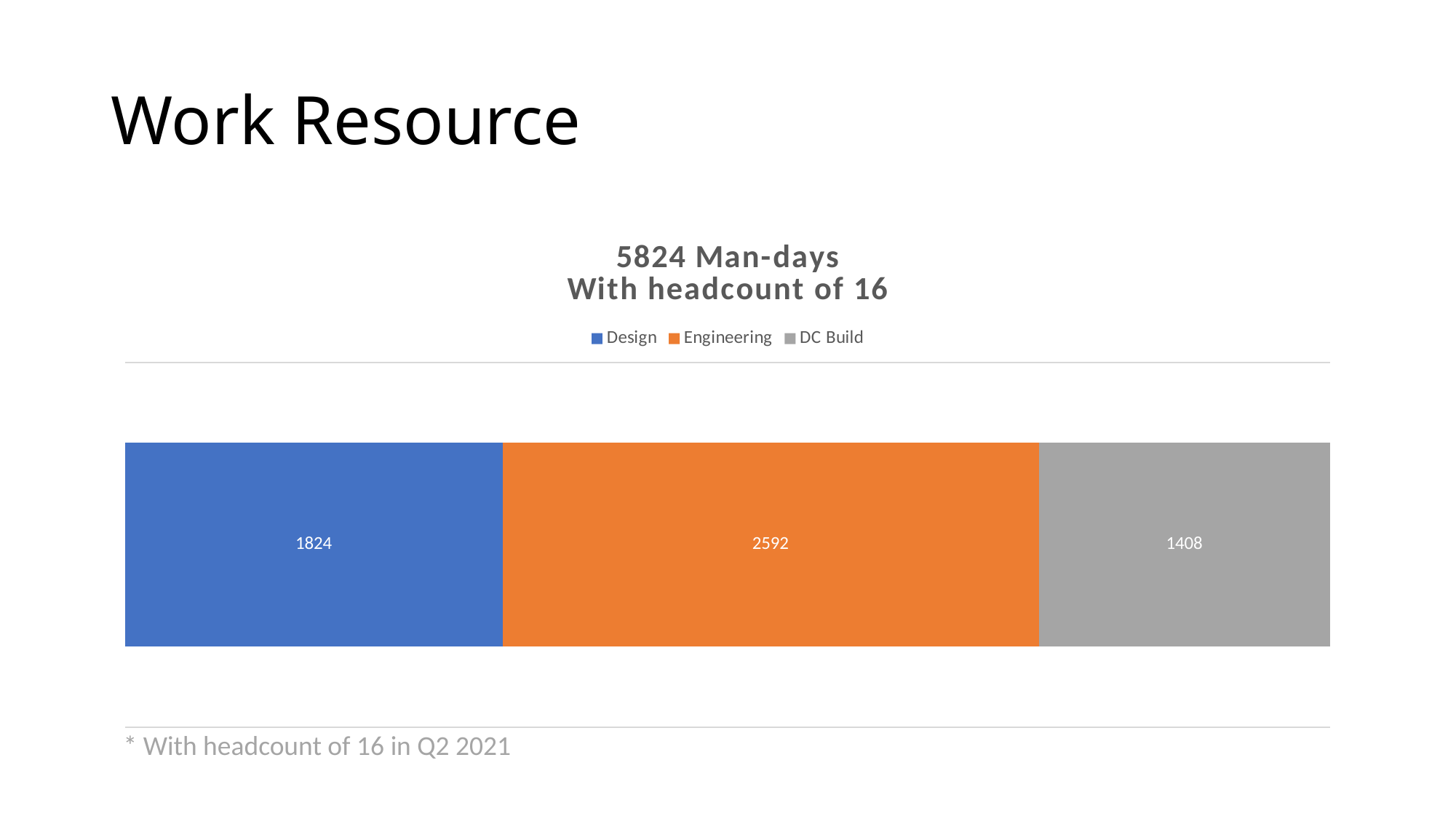
How many series does the legend list? 3 What is the value for Design? 1824 Which is larger, Design or DC Build? Design What is the total of the stacked bar? 5824 What kind of chart is shown? Stacked bar chart What is the value for Engineering? 2592 What is the difference between the Design and DC Build values? 416 What is the value for DC Build? 1408 What is the difference between the Engineering and Design values? 768 What is the title of the chart? 5824 Man-days With headcount of 16 Which series has the lowest value? DC Build Which series has the highest value? Engineering